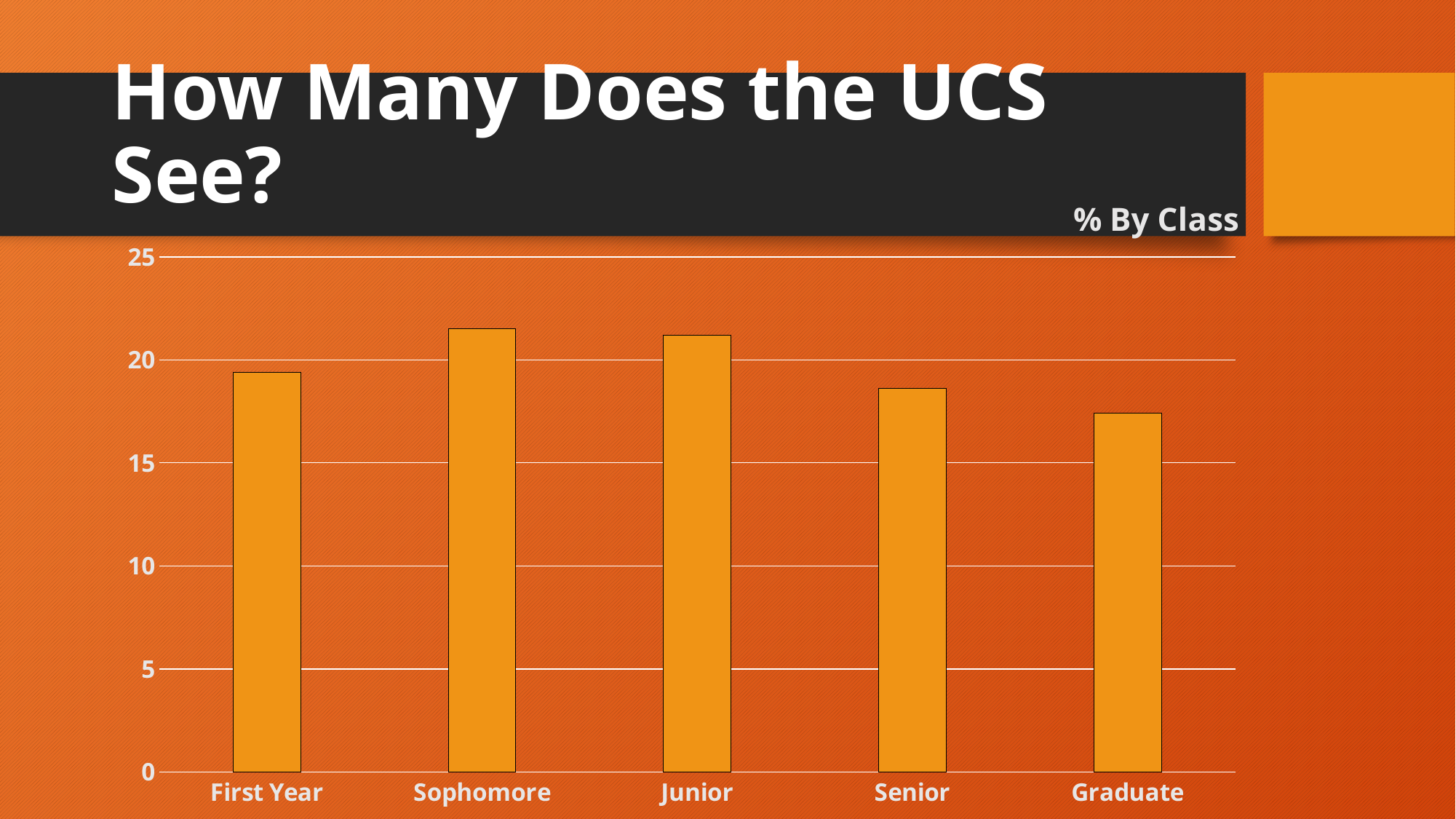
Is the value for Junior greater or less than 20? greater Which class has the lowest value? Graduate Is the value for Sophomore greater or less than 20? greater What is the highest value shown on the y axis? 25 What is the title of the chart? % By Class Is the value for Graduate greater or less than 15? greater Which is larger, the value for First Year or the value for Graduate? First Year What kind of chart is shown on the slide? bar chart How many class categories are shown on the x axis? 5 Which is larger, the value for Sophomore or the value for Senior? Sophomore